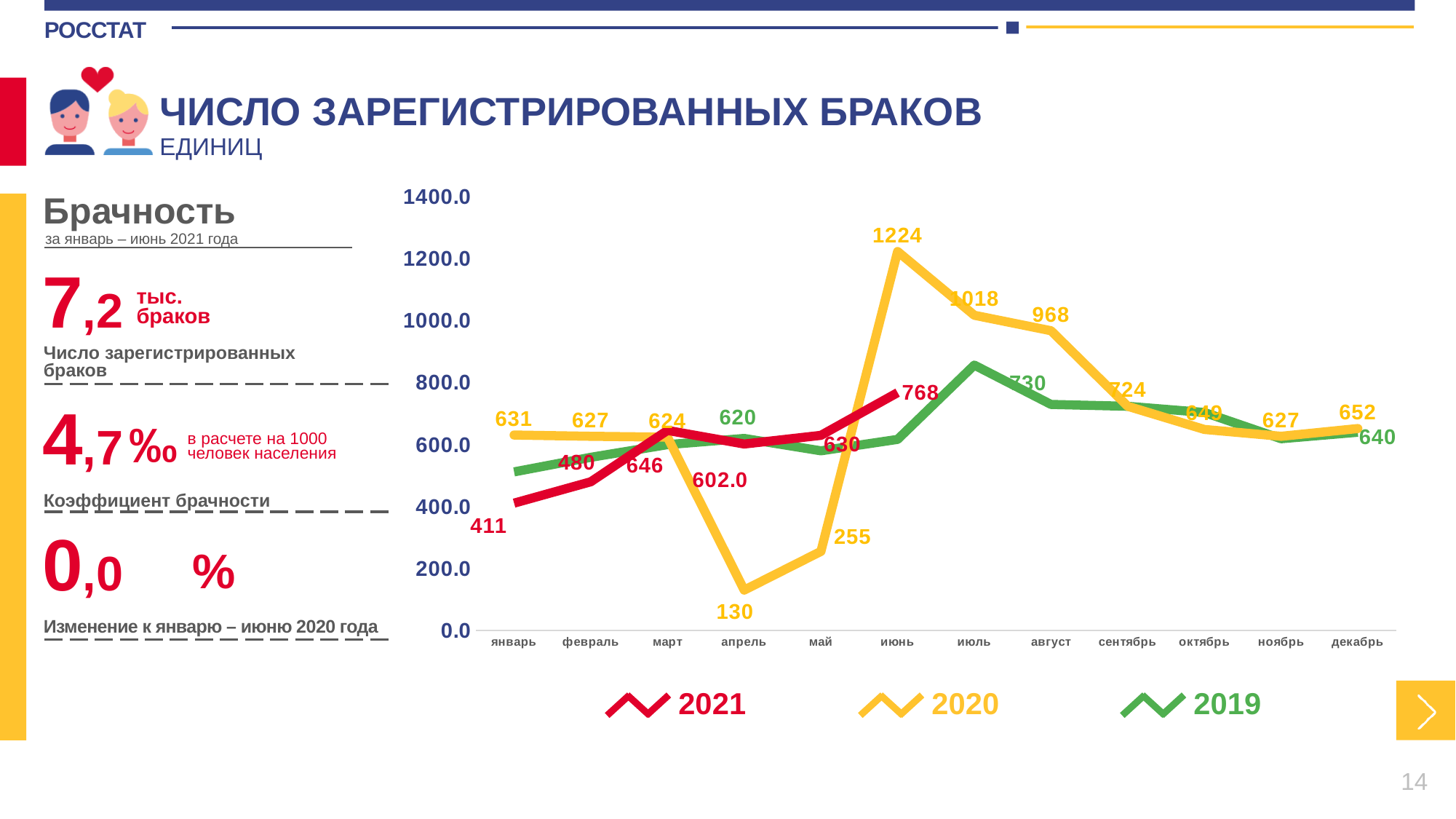
How many months are shown on the x axis? 12 What is the value for 2019 in август (August)? 730 In which month does the 2020 series reach its highest value? июнь What is the value for 2021 in январь (January)? 411 How many series does the legend list? 3 What is the value for 2020 in апрель (April)? 130 What is the difference between the 2020 values for июнь and май? 969 What is the value for 2021 in июнь (June)? 768 What kind of chart is shown on the slide? line chart Is the value for 2019 in июль (July) greater or less than 800? greater Which series has the larger value in март (March): 2021 or 2020? 2021 In which month does the 2020 series have its lowest value? апрель